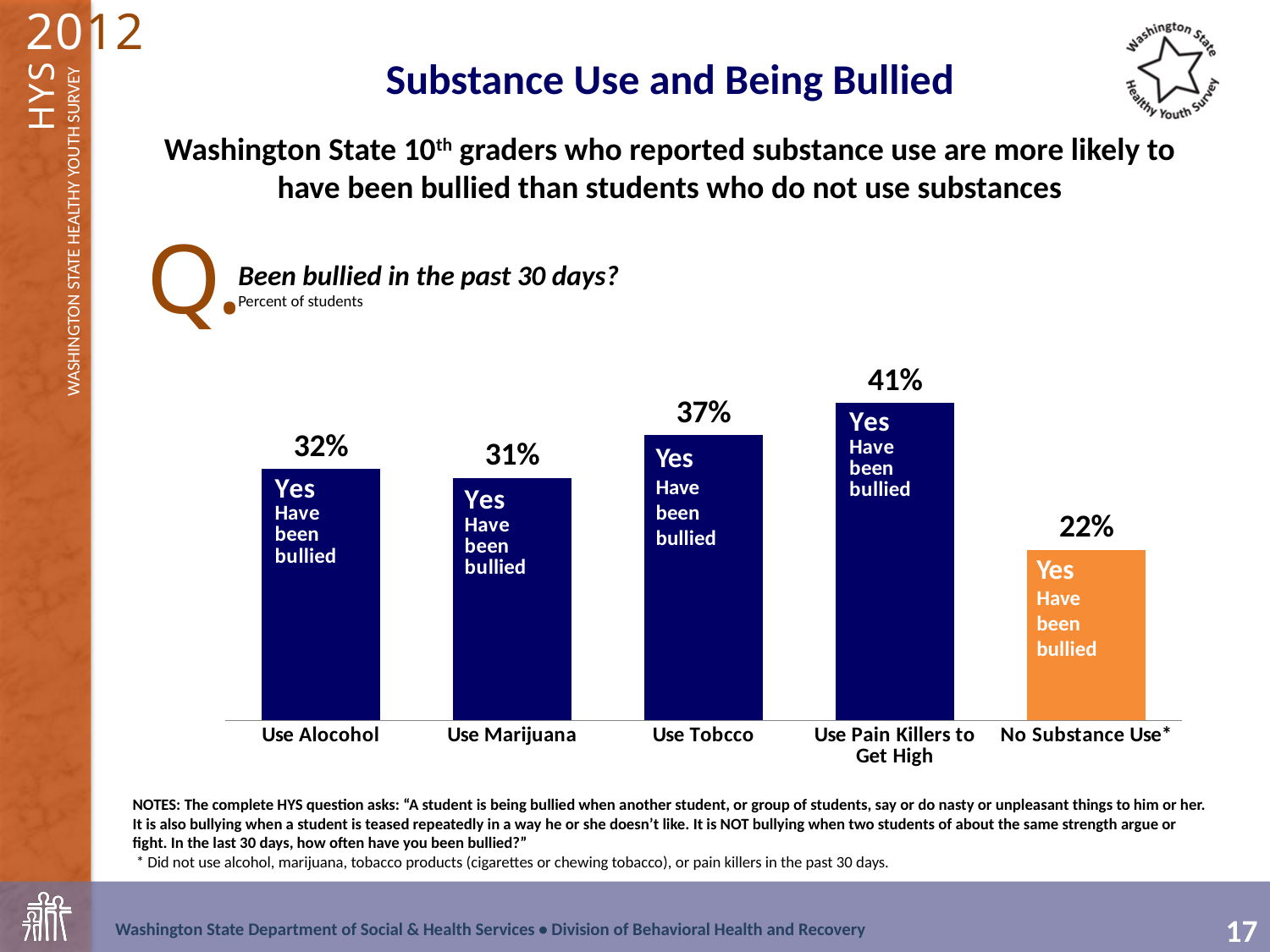
What percentage of students with no substance use reported having been bullied? 22% What percentage of students who use marijuana reported having been bullied? 31% What is the difference in percentage points between the 'Use Pain Killers to Get High' bar and the 'No Substance Use*' bar? 19 What percentage of students who use alcohol reported having been bullied in the past 30 days? 32% Which bar in the chart is coloured orange rather than dark blue? No Substance Use* Which category has the lowest percentage of students who have been bullied? No Substance Use* What is the difference in percentage points between the 'Use Alocohol' bar and the 'Use Marijuana' bar? 1 How many categories are shown on the x axis of the chart? 5 What is the value shown for the 'Use Tobcco' bar? 37% Which category has the highest percentage of students who have been bullied? Use Pain Killers to Get High Which is larger: the value for 'Use Tobcco' or the value for 'Use Alocohol'? Use Tobcco What kind of chart is shown on the slide? Bar chart